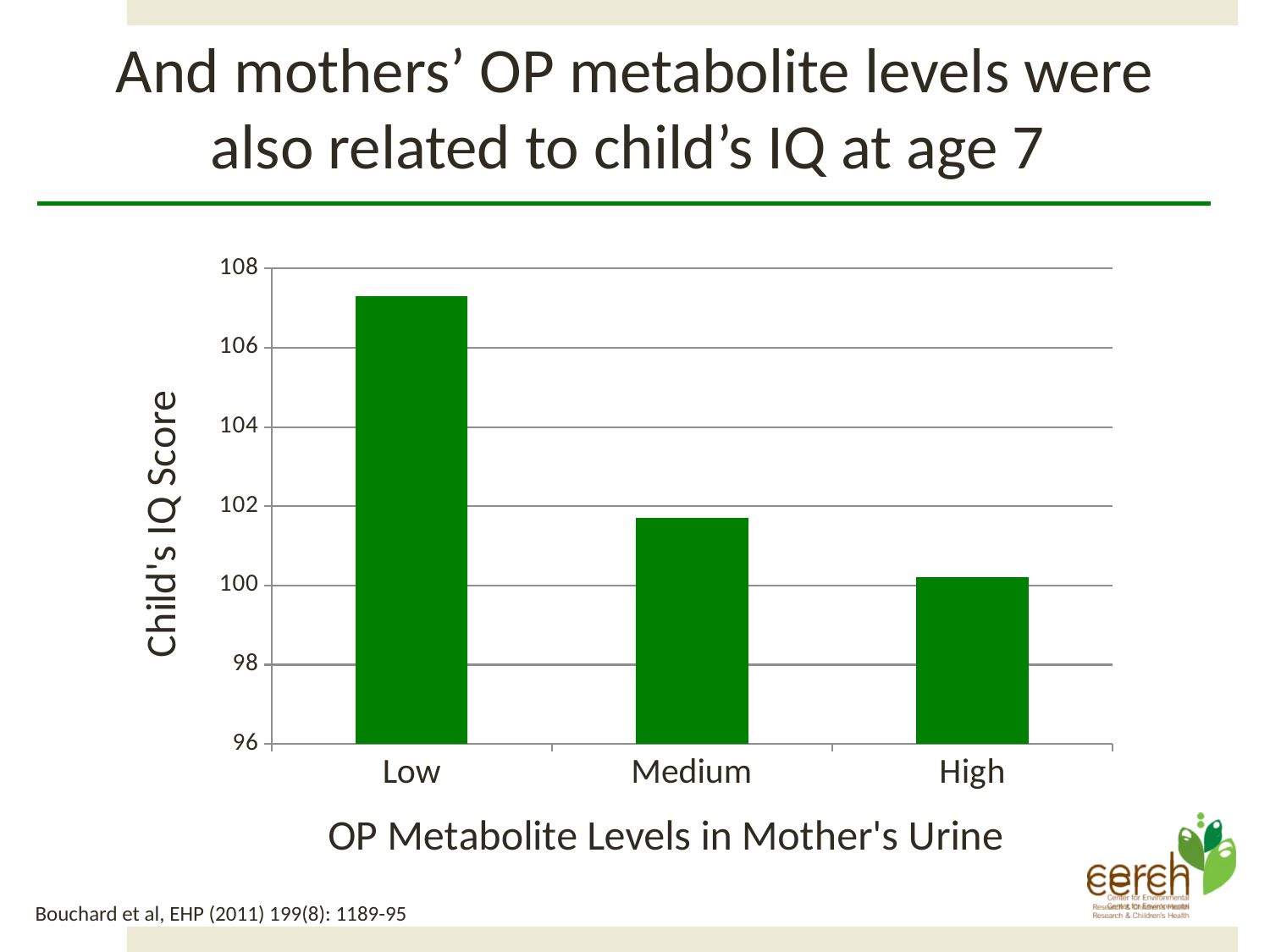
What is the title of the x axis of the chart? OP Metabolite Levels in Mother's Urine Which has a higher child's IQ score, Medium or High OP metabolite levels? Medium Which has a higher child's IQ score, Low or Medium OP metabolite levels? Low Is the child's IQ score for the Low category greater or less than 106? greater Which OP metabolite level category has the highest child's IQ score? Low Which OP metabolite level category has the lowest child's IQ score? High Is the child's IQ score for the High category greater or less than 102? less What is the title of the y axis of the chart? Child's IQ Score Do the child's IQ scores rise or fall as OP metabolite levels go from Low to High? fall How many categories are shown on the x axis of the chart? 3 What kind of chart is shown on the slide? bar chart Is the child's IQ score for the Medium category greater or less than 102? less